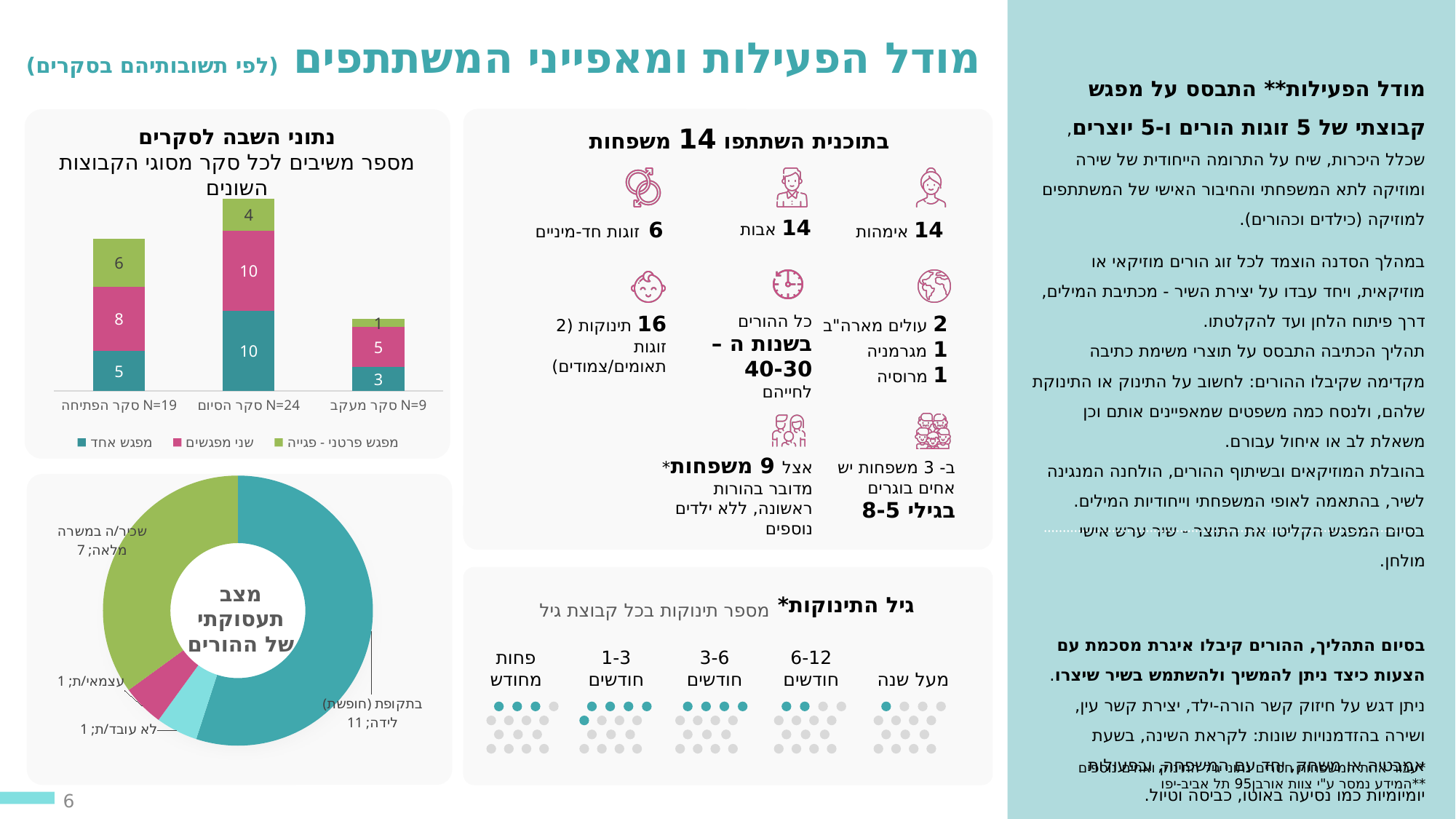
In the stacked bar chart 'נתוני השבה לסקרים', what is the value of the 'מפגש פרטני - פגייה' series for 'סקר מעקב N=9'? 1 How many series does the legend of the stacked bar chart 'נתוני השבה לסקרים' list? 3 In the stacked bar chart 'נתוני השבה לסקרים', which survey has the highest total number of respondents? סקר הסיום N=24 In the stacked bar chart 'נתוני השבה לסקרים', what is the total of the stacked bar for 'סקר הסיום N=24'? 24 What kind of chart is 'נתוני השבה לסקרים'? Stacked bar chart In the donut chart 'מצב תעסוקתי של ההורים', what is the value for 'בתקופת (חופשת) לידה'? 11 In the donut chart 'מצב תעסוקתי של ההורים', is the value for 'שכיר/ה במשרה מלאה' larger or smaller than the value for 'בתקופת (חופשת) לידה'? smaller In the stacked bar chart 'נתוני השבה לסקרים', which survey has the lowest total number of respondents? סקר מעקב N=9 In the stacked bar chart 'נתוני השבה לסקרים', what is the value of the 'מפגש אחד' series for 'סקר הסיום N=24'? 10 In the stacked bar chart 'נתוני השבה לסקרים', what is the difference between the 'מפגש פרטני - פגייה' values for 'סקר הפתיחה N=19' and 'סקר הסיום N=24'? 2 In the donut chart 'מצב תעסוקתי של ההורים', which category has the largest slice? בתקופת (חופשת) לידה In the stacked bar chart 'נתוני השבה לסקרים', what is the value of the 'שני מפגשים' series for 'סקר הפתיחה N=19'? 8